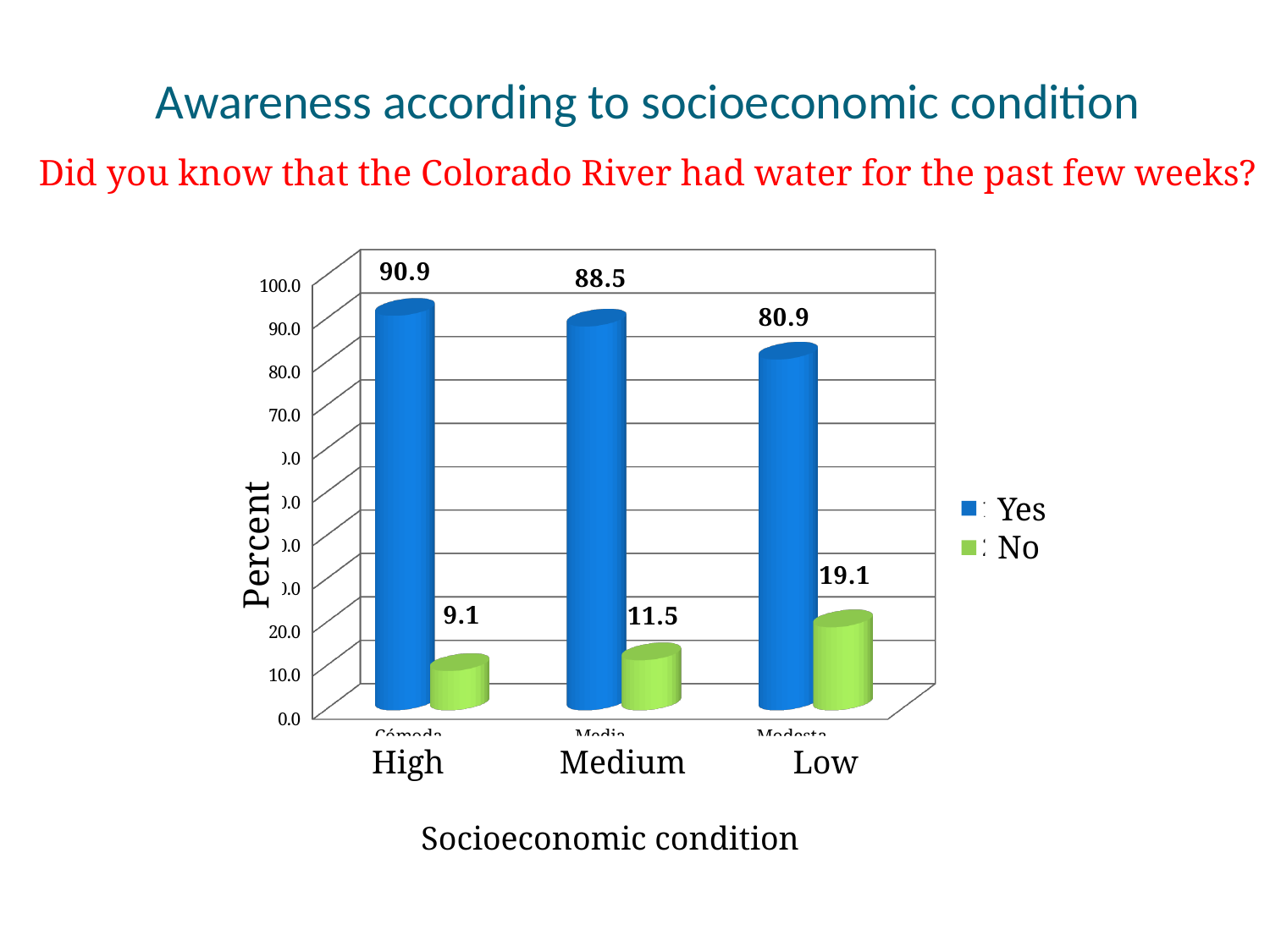
Which socioeconomic condition has the highest 'Yes' value? High What is the difference between the 'Yes' values for High and Low? 10.0 What kind of chart is shown on the slide? Bar chart Do the 'Yes' values rise or fall from High to Low along the x axis? Fall How many socioeconomic condition categories are shown on the x axis? 3 What is the 'No' value for the Low socioeconomic condition? 19.1 What is the 'Yes' value for the Medium socioeconomic condition? 88.5 What is the 'No' value for the Medium socioeconomic condition? 11.5 Which socioeconomic condition has the lowest 'No' value? High How many series does the legend list? 2 Which is larger: the 'No' value for Low or the 'No' value for Medium? Low What is the 'Yes' value for the High socioeconomic condition? 90.9